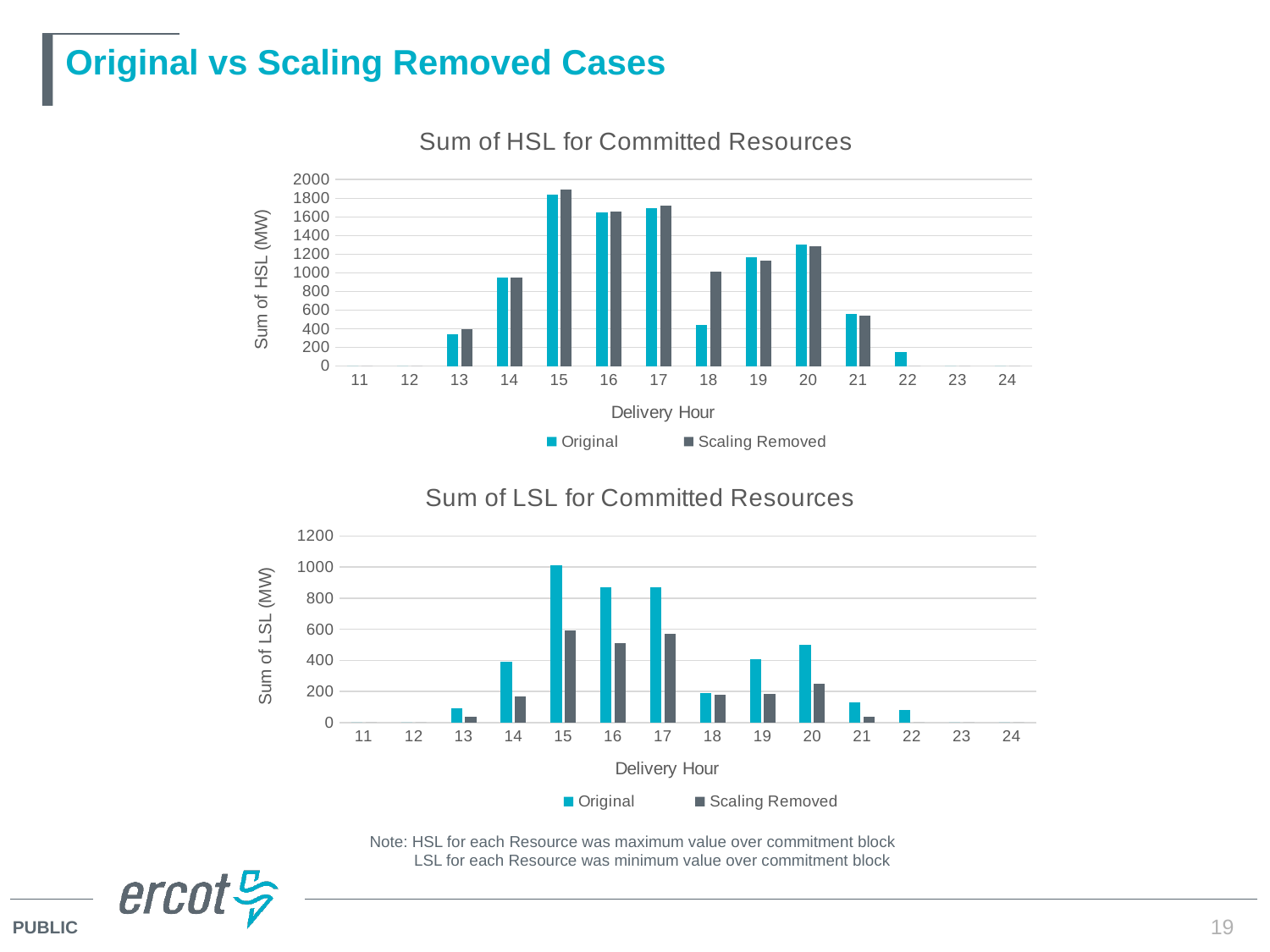
How many series does the legend of the top chart, 'Sum of HSL for Committed Resources', list? 2 In the bottom chart, 'Sum of LSL for Committed Resources', at delivery hour 16, which series is larger: Original or Scaling Removed? Original In the bottom chart, 'Sum of LSL for Committed Resources', is the Original value at delivery hour 20 greater or less than 400? greater In the top chart, 'Sum of HSL for Committed Resources', at which delivery hour is the Original series highest? 15 In the bottom chart, 'Sum of LSL for Committed Resources', at which delivery hour is the Scaling Removed series highest? 15 In the top chart, 'Sum of HSL for Committed Resources', is the Original value at delivery hour 15 greater or less than 1600? greater What is the y-axis label of the bottom chart, 'Sum of LSL for Committed Resources'? Sum of LSL (MW) In the bottom chart, 'Sum of LSL for Committed Resources', is the Original value at delivery hour 15 greater or less than 800? greater What type of chart is the top chart, 'Sum of HSL for Committed Resources'? bar chart How many delivery hours are shown on the x axis of the bottom chart, 'Sum of LSL for Committed Resources'? 14 In the top chart, 'Sum of HSL for Committed Resources', at delivery hour 18, which series is larger: Original or Scaling Removed? Scaling Removed